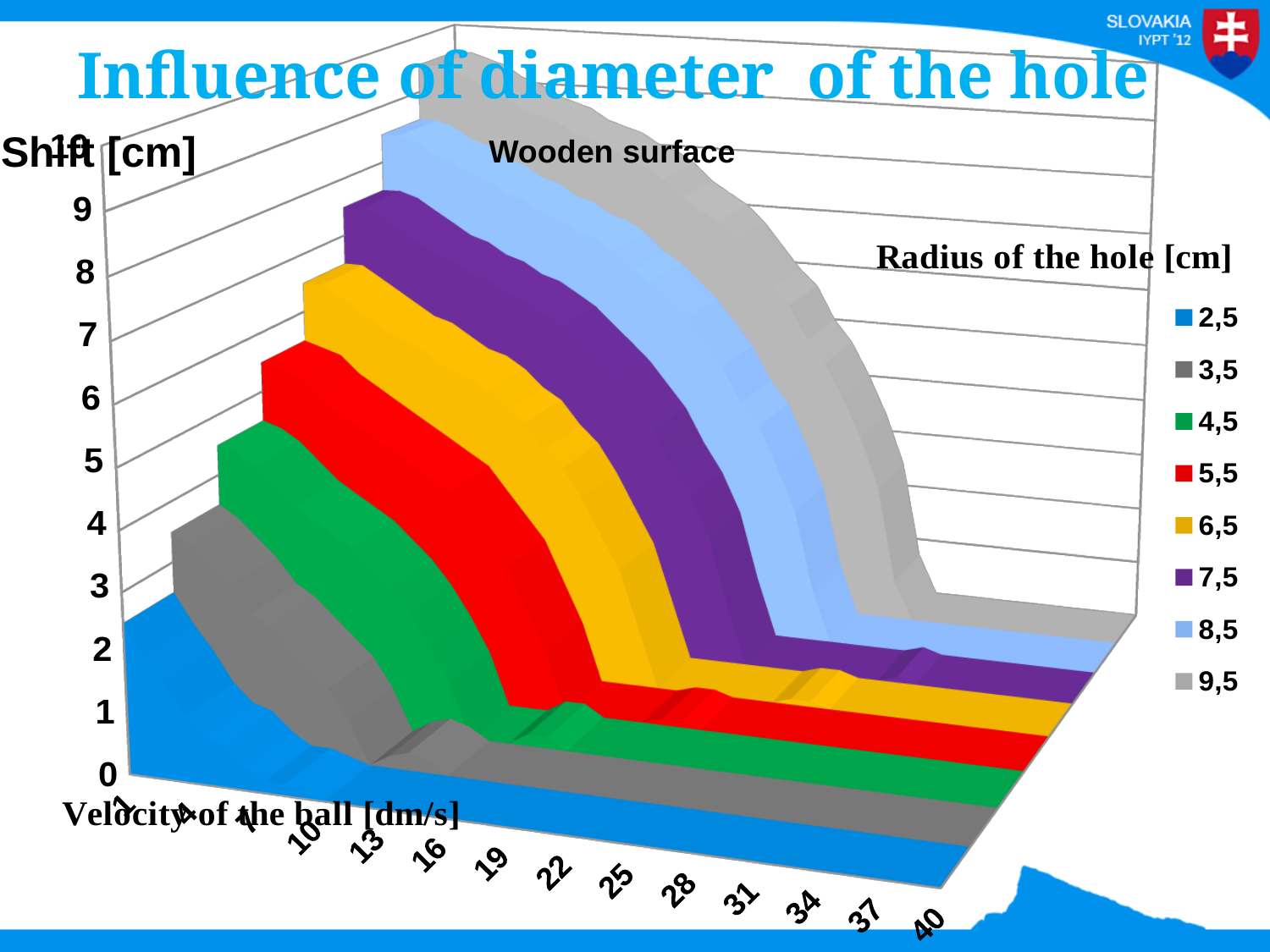
Do the shift values rise or fall as the velocity of the ball increases along the x axis? fall How many series does the legend list? 8 What is the title of the chart? Wooden surface What is the smallest radius of the hole listed in the legend? 2,5 What is the largest radius of the hole listed in the legend? 9,5 What is the largest velocity value labelled on the x axis? 40 What quantity does the legend represent, according to its heading? Radius of the hole [cm] What is the highest value labelled on the vertical Shift axis? 10 What unit is used for the velocity of the ball on the x axis? dm/s What kind of chart is shown on the slide? 3D area chart